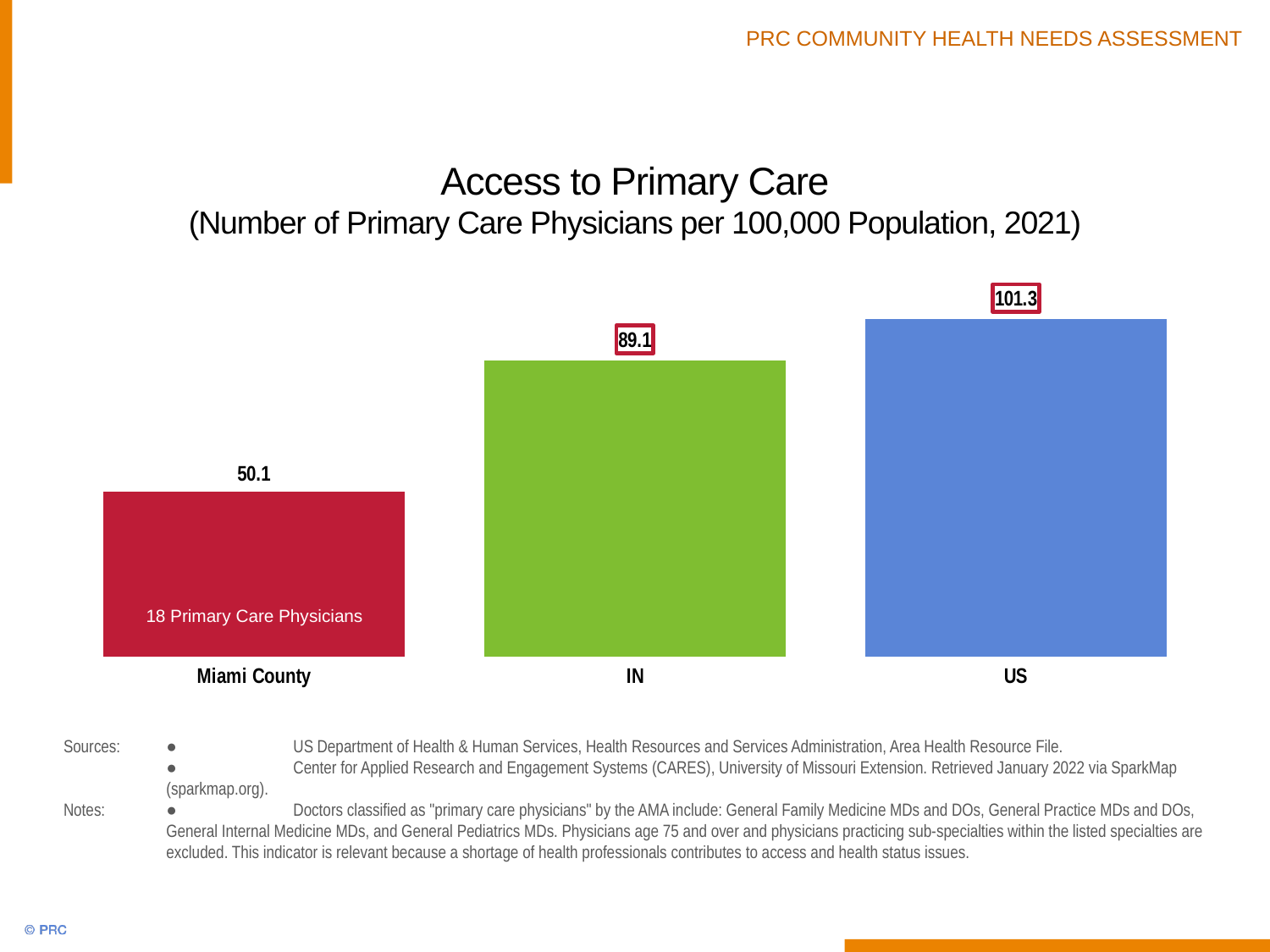
Which category has the highest value on the chart? US What is the number of primary care physicians per 100,000 population for the US? 101.3 What is the difference between the IN value and the Miami County value? 39.0 Which category has the lowest value on the chart? Miami County What is the number of primary care physicians per 100,000 population for Miami County? 50.1 How many categories are shown on the chart? 3 Do the values rise or fall moving from left to right across the chart? Rise What is the number of primary care physicians per 100,000 population for IN? 89.1 What is the difference between the US value and the Miami County value? 51.2 How many primary care physicians does the label inside the Miami County bar report? 18 Which is larger, the value for IN or the value for the US? US What kind of chart is shown on the slide? Bar chart